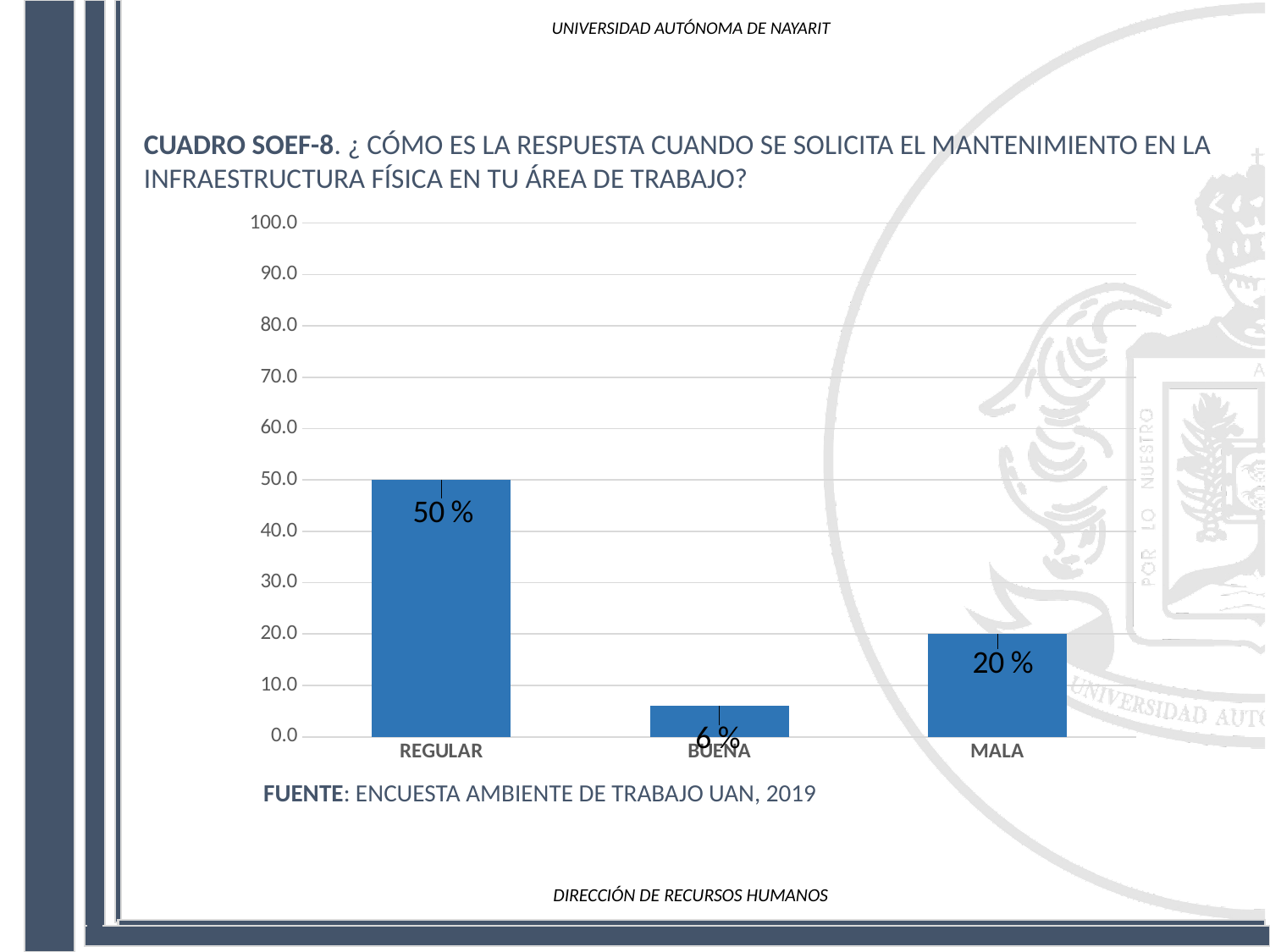
What is the value for REGULAR? 50 % What is the value for MALA? 20 % Which category has the lowest value? BUENA How many categories are shown on the x axis? 3 Is the value for REGULAR greater or less than 40.0? greater What is the value for BUENA? 6 % What is the difference between the values for MALA and BUENA? 14 % What kind of chart is shown on the slide? bar chart What is the source cited below the chart? ENCUESTA AMBIENTE DE TRABAJO UAN, 2019 Which is larger, the value for MALA or the value for BUENA? MALA What is the difference between the values for REGULAR and MALA? 30 % Which category has the highest value? REGULAR